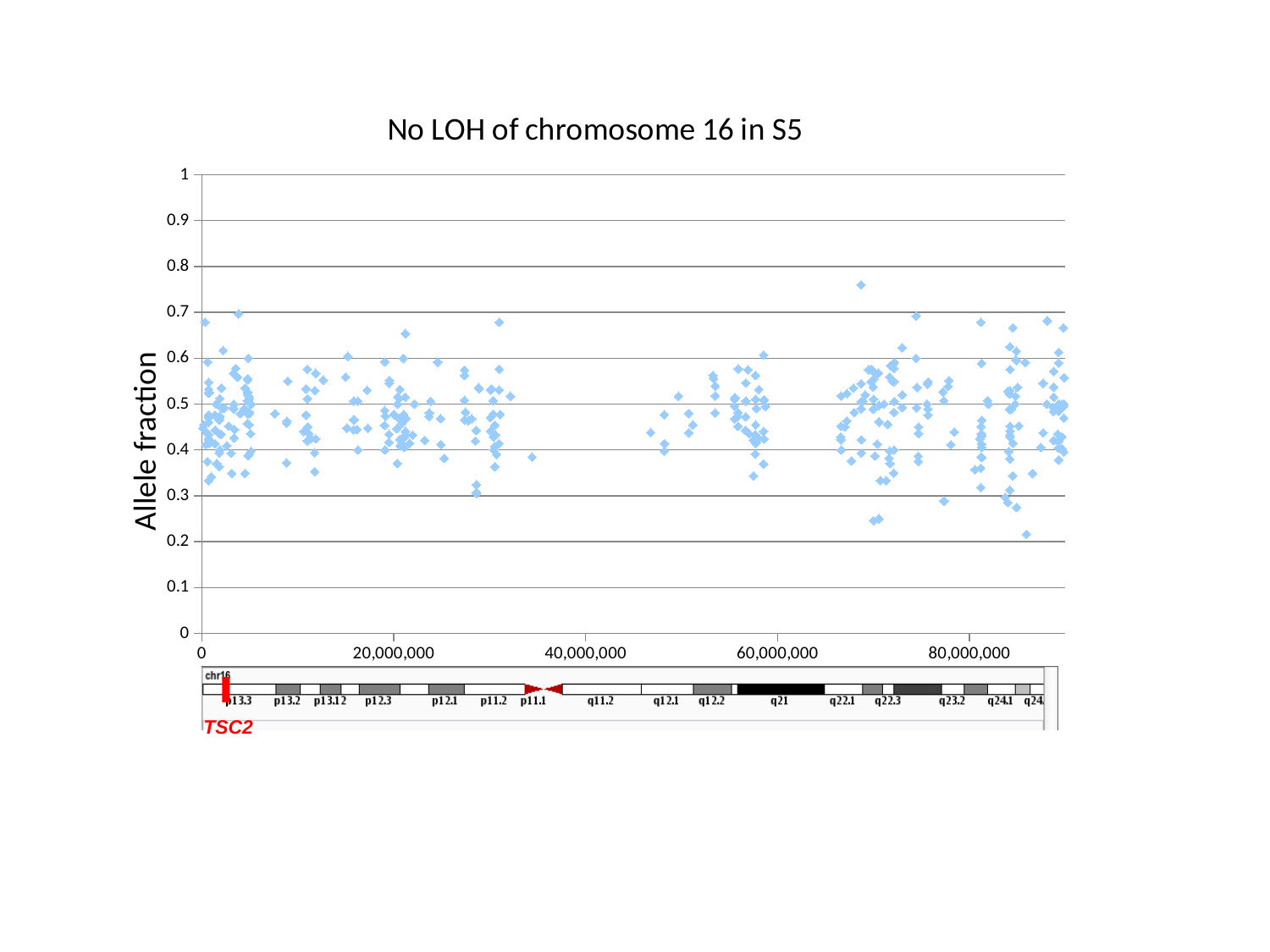
What is the spacing between consecutive gridlines on the y axis? 0.1 Is the highest plotted allele fraction greater or less than 0.7? greater What is the largest tick value shown on the x axis? 80,000,000 Is the highest plotted allele fraction greater or less than 0.8? less Is the lowest plotted allele fraction greater or less than 0.1? greater What is the label of the y axis? Allele fraction Are there any points plotted between x = 40,000,000 and x = 45,000,000? No Does the allele fraction show a clear rising or falling trend along the x axis, or does it stay roughly flat? roughly flat What kind of chart is shown on the slide? scatter plot What is the maximum value shown on the y axis? 1 What is the title of the chart? No LOH of chromosome 16 in S5